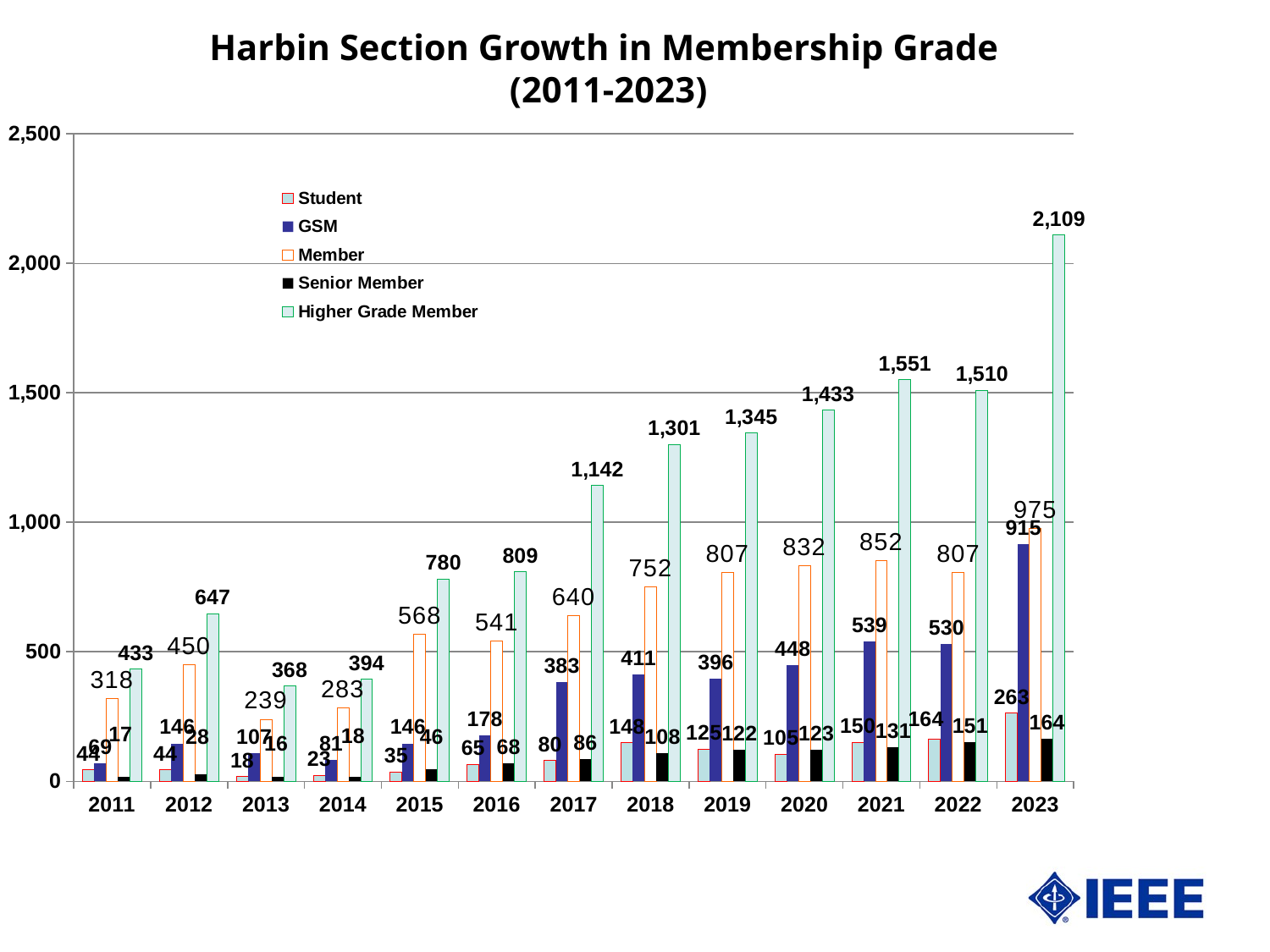
Is the Member value for 2023 greater or less than 500? greater What is the value for Higher Grade Member in 2023? 2,109 What is the value for Member in 2021? 852 In which year is the Higher Grade Member value highest? 2023 How many years are shown on the x axis? 13 What kind of chart is shown on the slide? bar chart What is the value for Student in 2023? 263 What is the difference between the Higher Grade Member values for 2023 and 2022? 599 What is the value for GSM in 2017? 383 In which year is the Higher Grade Member value lowest? 2013 Which is larger, the GSM value for 2021 or for 2022? 2021 How many series does the legend list? 5